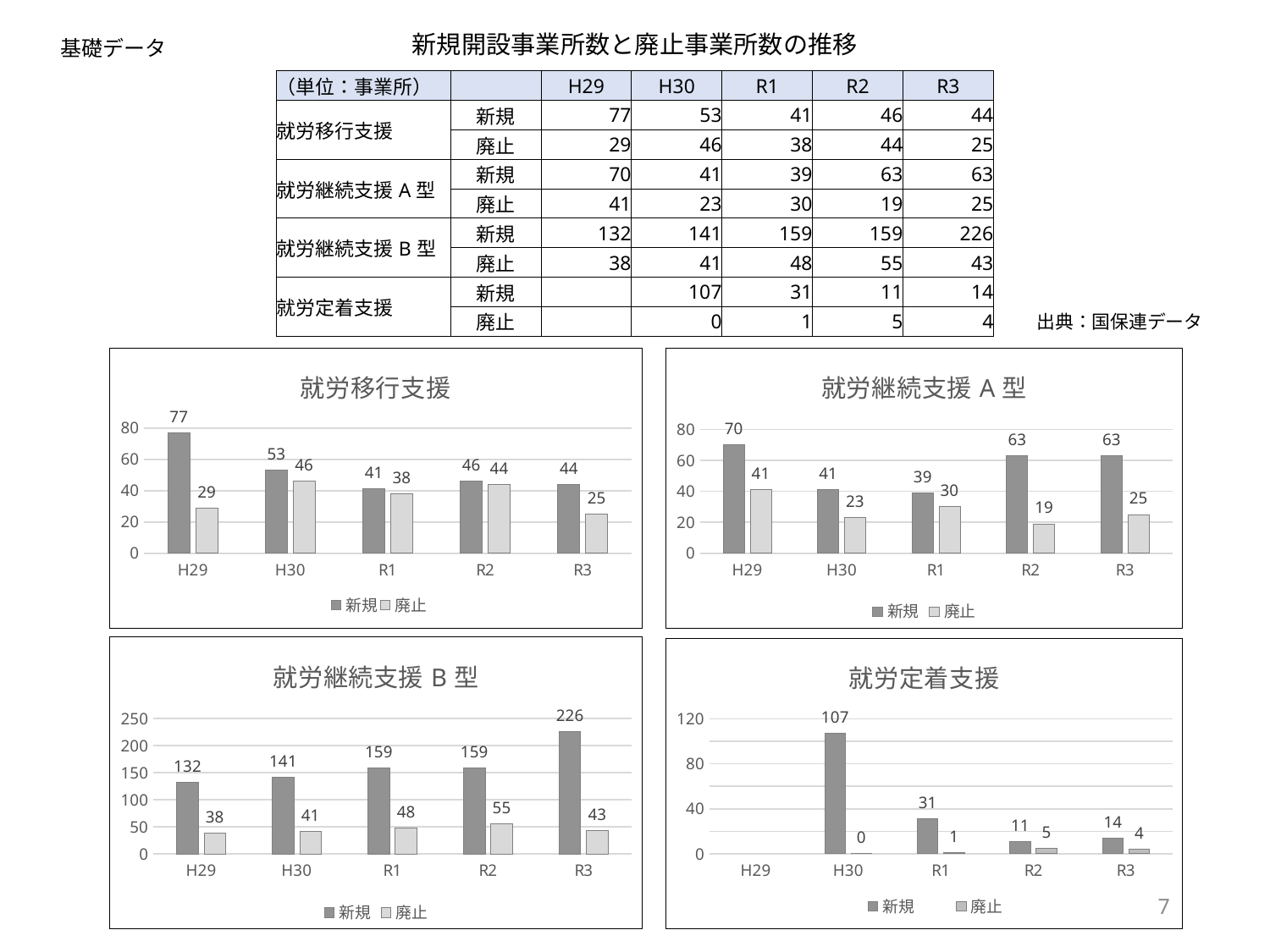
In the 就労継続支援Ａ型 chart, what is the 廃止 value for R2? 19 In the 就労移行支援 chart, which is larger in H30, 新規 or 廃止? 新規 In the 就労定着支援 chart, what is the 新規 value for H30? 107 In the 就労移行支援 chart, what is the 新規 value for H29? 77 In the 就労移行支援 chart, which year has the lowest 廃止 value? R3 In the 就労継続支援Ｂ型 chart, which year has the highest 新規 value? R3 What type of chart is the 就労定着支援 chart? bar chart In the 就労継続支援Ｂ型 chart, what is the 廃止 value for R2? 55 In the 就労継続支援Ｂ型 chart, is the 新規 value for R3 greater or less than 200? greater In the 就労継続支援Ａ型 chart, what is the difference between 新規 and 廃止 in H29? 29 In the 就労定着支援 chart, does the 新規 series rise or fall from H30 to R2? fall How many series does the legend of the 就労継続支援Ａ型 chart list? 2